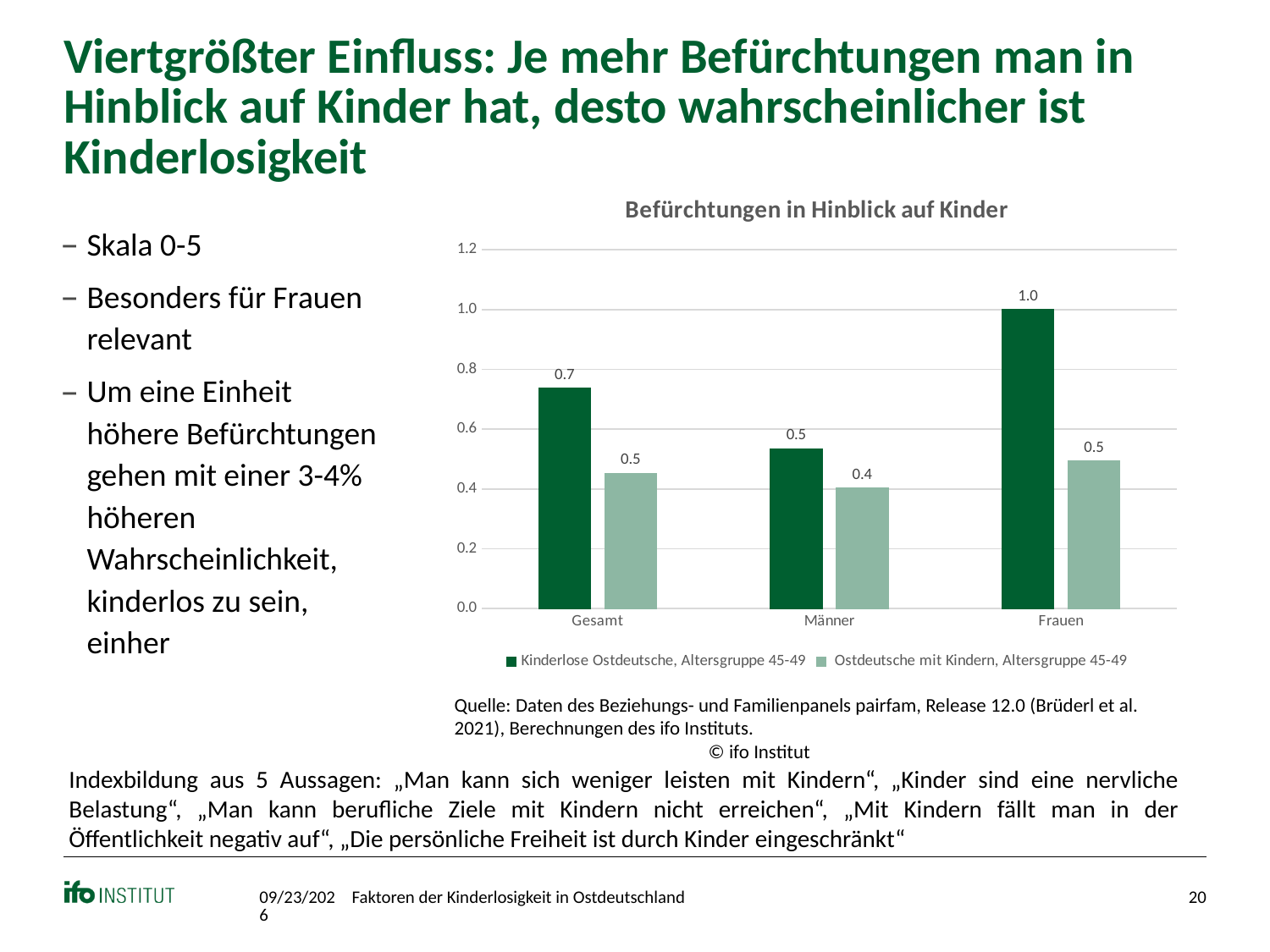
Is the value for Kinderlose Ostdeutsche, Altersgruppe 45-49 in the Frauen category greater or less than 0.8? greater What is the value for Ostdeutsche mit Kindern, Altersgruppe 45-49 in the Männer category? 0.4 Which category has the highest value for Kinderlose Ostdeutsche, Altersgruppe 45-49? Frauen What is the difference between the two series in the Gesamt category? 0.2 In the Frauen category, which series has the larger value? Kinderlose Ostdeutsche, Altersgruppe 45-49 Which category has the lowest value for Ostdeutsche mit Kindern, Altersgruppe 45-49? Männer How many series does the legend list? 2 What is the difference between the two series in the Frauen category? 0.5 What is the value for Kinderlose Ostdeutsche, Altersgruppe 45-49 in the Gesamt category? 0.7 What is the value for Kinderlose Ostdeutsche, Altersgruppe 45-49 in the Frauen category? 1.0 What kind of chart is shown on the slide? bar chart How many categories are shown on the x axis? 3